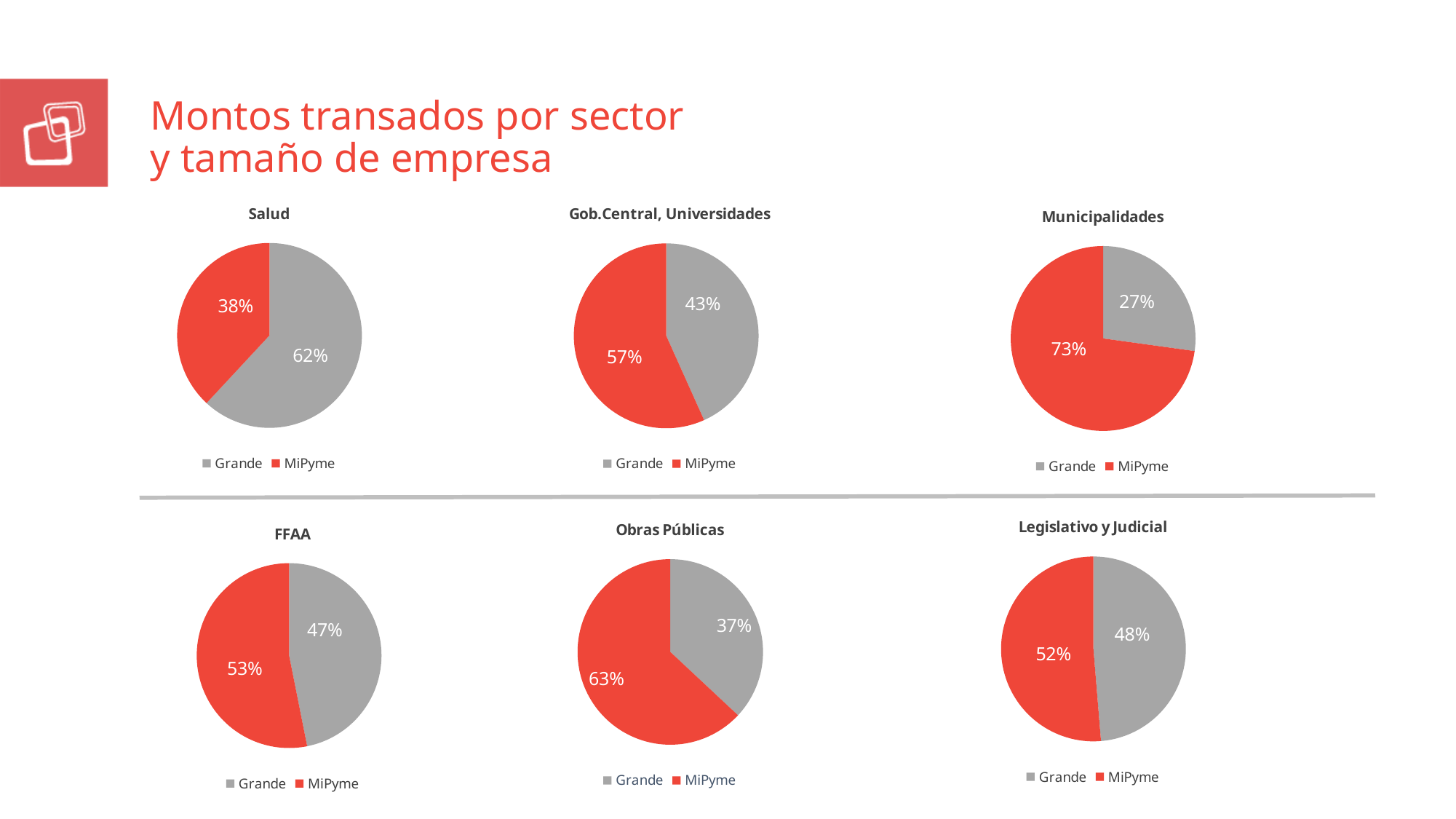
In the FFAA chart, what is the difference between the MiPyme and Grande shares? 6% In the Legislativo y Judicial chart, what share does MiPyme have? 52% In the Gob.Central, Universidades chart, which slice is larger, Grande or MiPyme? MiPyme How many entries does the legend of the FFAA chart list? 2 In the Salud chart, what share does Grande have? 62% How many pie charts are shown on the slide? 6 In the Legislativo y Judicial chart, which colour represents MiPyme? Red In the Municipalidades chart, what share does MiPyme have? 73% How many slices does the Obras Públicas pie chart have? 2 In the Salud chart, what is the difference between the Grande and MiPyme shares? 24% What kind of chart is the Municipalidades chart? Pie chart In the Obras Públicas chart, what share does Grande have? 37%